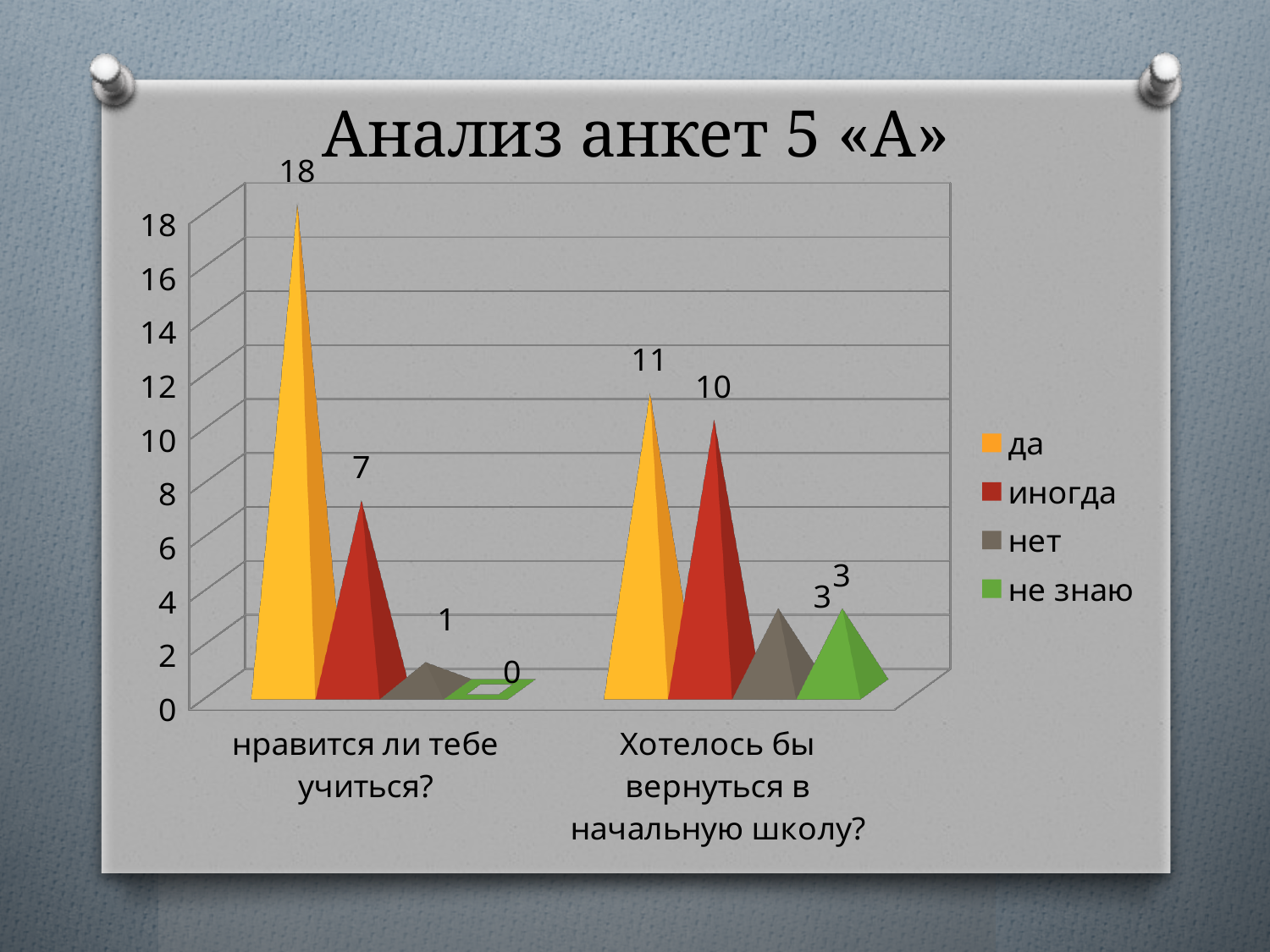
What is the value for "нет" in the category "нравится ли тебе учиться?"? 1 Which series has the lowest value in the category "нравится ли тебе учиться?"? не знаю What is the title of the slide? Анализ анкет 5 «А» How many categories are shown on the x axis? 2 What is the value for "да" in the category "нравится ли тебе учиться?"? 18 What kind of chart is shown on the slide? bar chart What is the difference between the "да" values for "нравится ли тебе учиться?" and "Хотелось бы вернуться в начальную школу?"? 7 Which series has the highest value in the category "Хотелось бы вернуться в начальную школу?"? да How many series does the legend list? 4 Which is larger: the "иногда" value for "нравится ли тебе учиться?" or for "Хотелось бы вернуться в начальную школу?"? Хотелось бы вернуться в начальную школу? What is the value for "не знаю" in the category "Хотелось бы вернуться в начальную школу?"? 3 What is the value for "иногда" in the category "Хотелось бы вернуться в начальную школу?"? 10